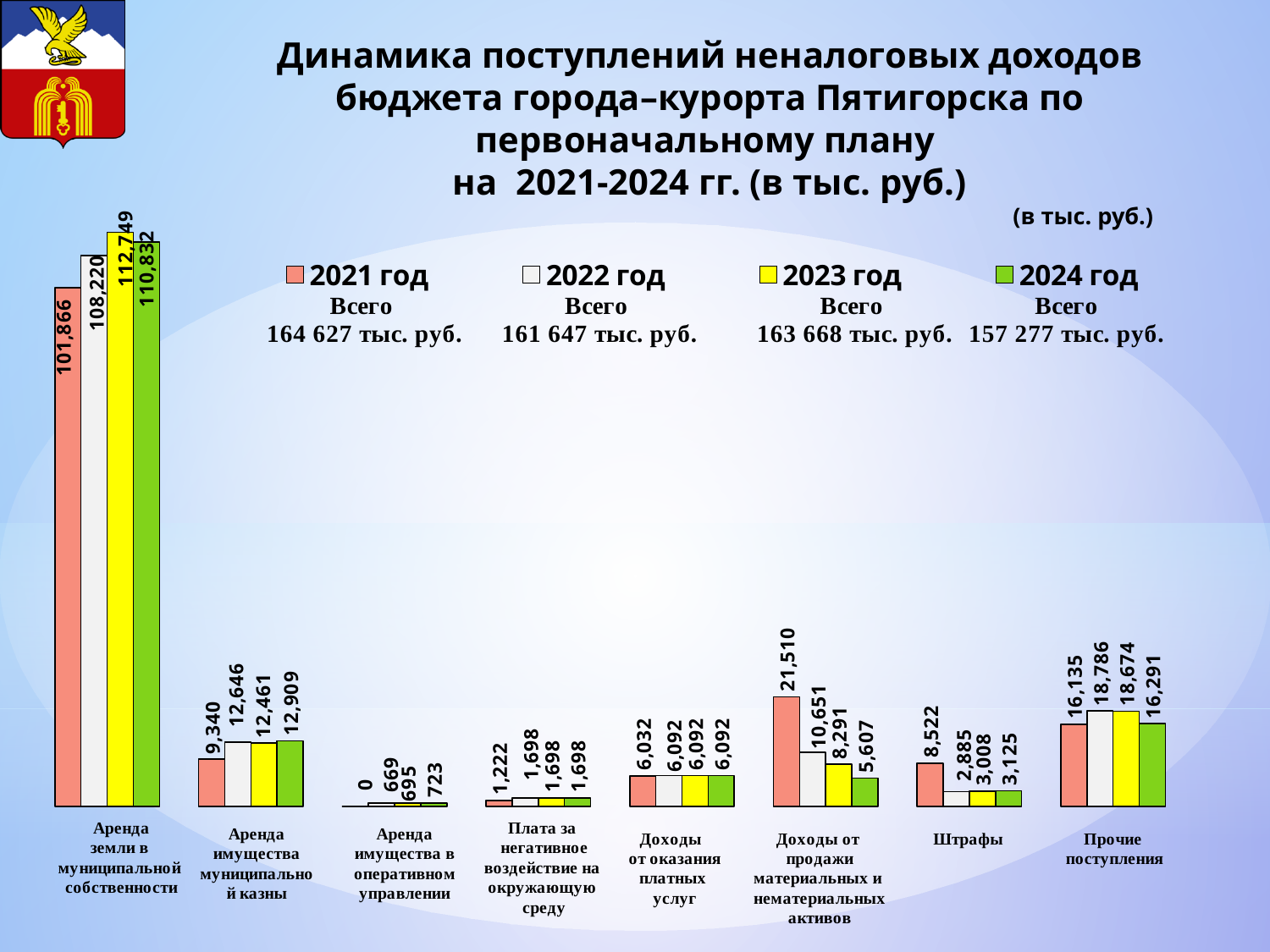
Which year has the highest value for Аренда земли в муниципальной собственности? 2023 год Which year has the lowest value for Аренда имущества в оперативном управлении? 2021 год What kind of chart is shown on the slide? Bar chart Do the values for Доходы от продажи материальных и нематериальных активов rise or fall from 2021 год to 2024 год? Fall What is the value for Доходы от продажи материальных и нематериальных активов in 2024 год? 5,607 Which is larger for Прочие поступления: the 2022 год value or the 2024 год value? 2022 год How many categories are shown on the x axis of the chart? 8 What is the value for Аренда земли в муниципальной собственности in 2021 год? 101,866 What total (Всего) is shown in the legend for 2024 год? 157 277 тыс. руб. What is the difference between the 2021 год and 2024 год values for Доходы от продажи материальных и нематериальных активов? 15,903 How many series does the legend list? 4 What is the value for Штрафы in 2022 год? 2,885